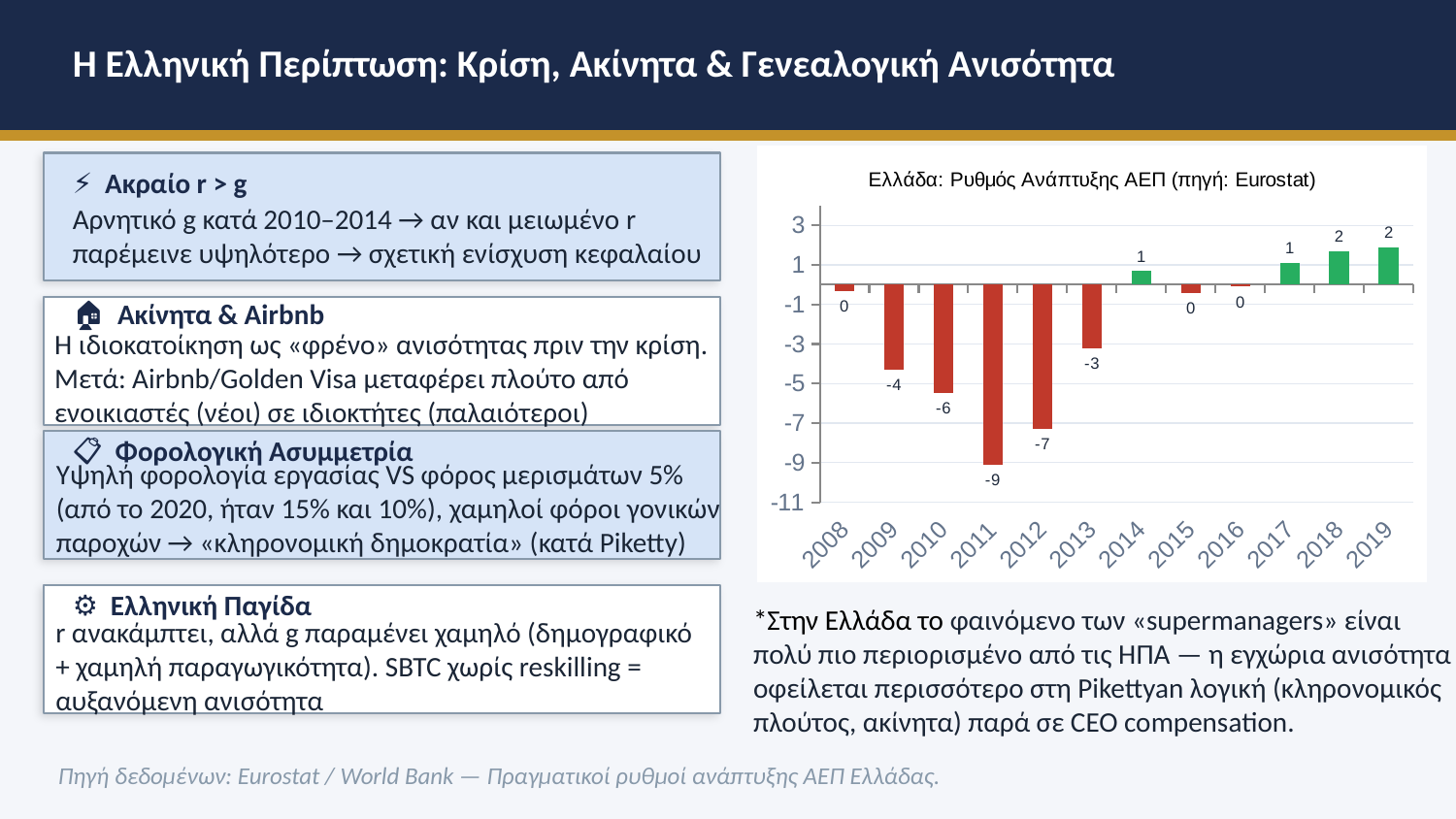
What is the value shown for 2009? -4 What is the value shown for 2013? -3 Which year has the lowest GDP growth rate in the chart? 2011 Which year has the larger value, 2009 or 2013? 2013 What is the value shown for 2018? 2 What is the difference between the values for 2010 and 2012? 1 What is the GDP growth rate shown for 2011? -9 What kind of chart is used to show Greece's GDP growth rate? Bar chart Do the values rise or fall from 2011 to 2019? Rise How many years are shown on the x axis of the chart? 12 What colour are the bars with positive values in the chart? Green Is the value for 2012 greater or less than -5? less